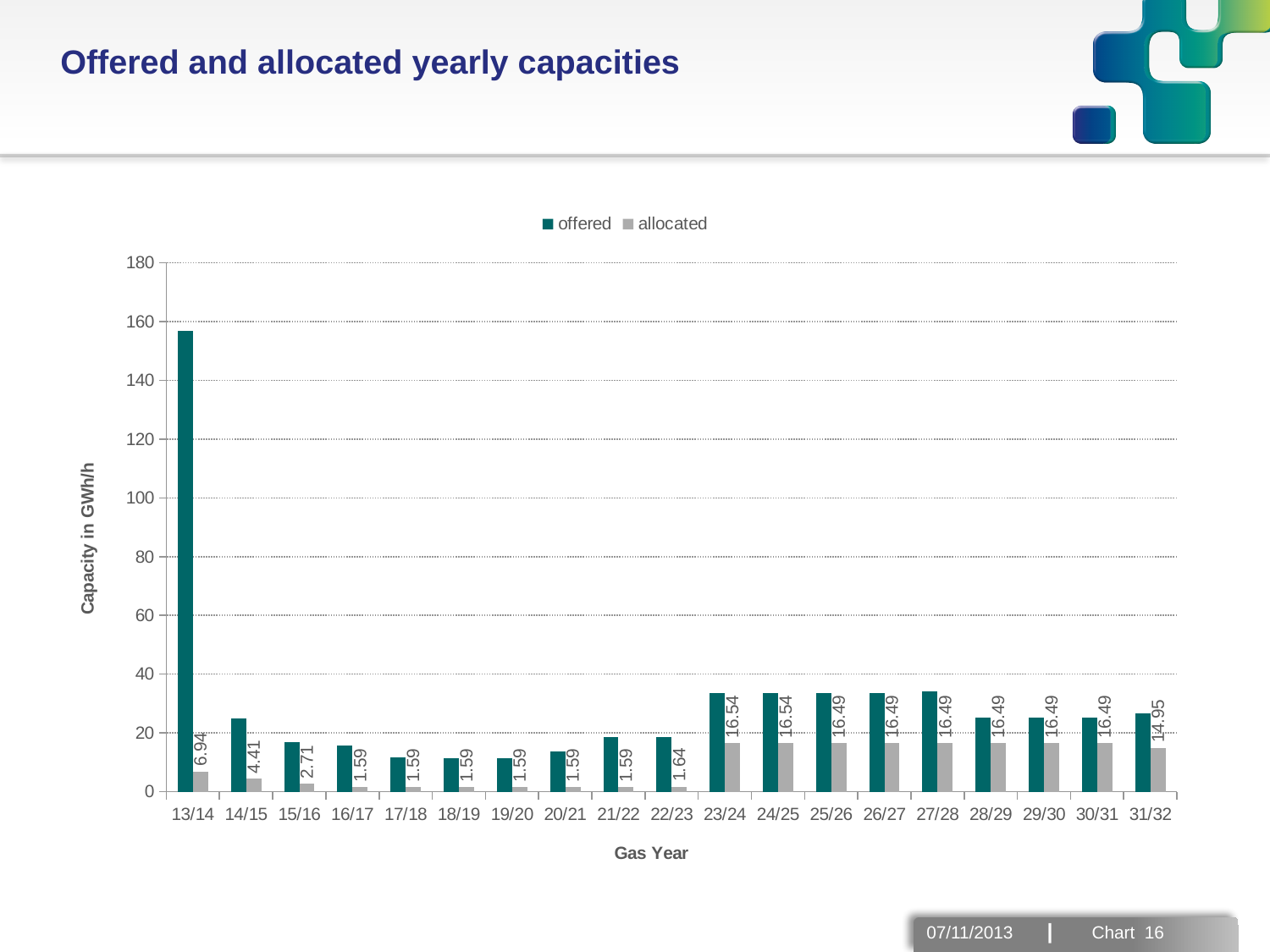
What is the allocated capacity for gas year 13/14? 6.94 Is the offered capacity for gas year 14/15 greater or less than 20? greater What kind of chart is shown on the slide? bar chart How many series does the legend list? 2 What is the allocated capacity for gas year 31/32? 14.95 Which gas year has the highest offered capacity? 13/14 Which gas year has the larger allocated capacity, 15/16 or 22/23? 15/16 What is the difference between the allocated capacity in 24/25 and in 25/26? 0.05 What is the difference between the allocated capacity in 13/14 and in 14/15? 2.53 How many gas years are shown on the x axis? 19 What is the allocated capacity for gas year 23/24? 16.54 Is the offered capacity for gas year 13/14 greater or less than 140? greater